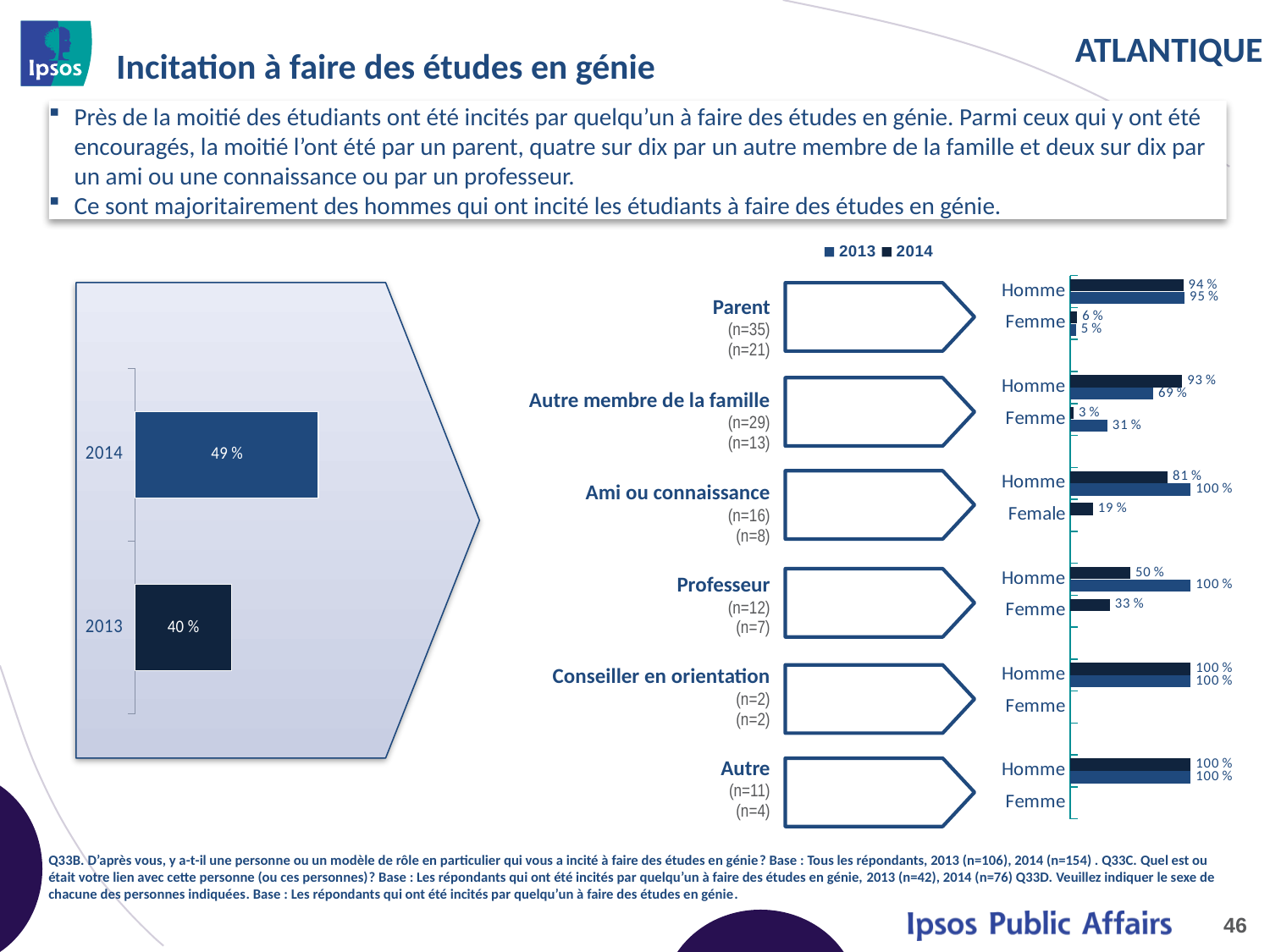
In the right chart, how many relationship categories (Parent, Autre membre de la famille, etc.) are shown? 6 In the left chart, what is the value for 2014? 49 % In the right chart, what is the difference between the 2013 and 2014 values for Homme under Autre membre de la famille? 24 % In the left chart, which year has the higher value, 2013 or 2014? 2014 In the right chart, how many series does the legend list? 2 In the left chart, what is the value for 2013? 40 % What kind of chart is the left chart? Bar chart In the left chart, what is the difference between the 2014 and 2013 values? 9 %